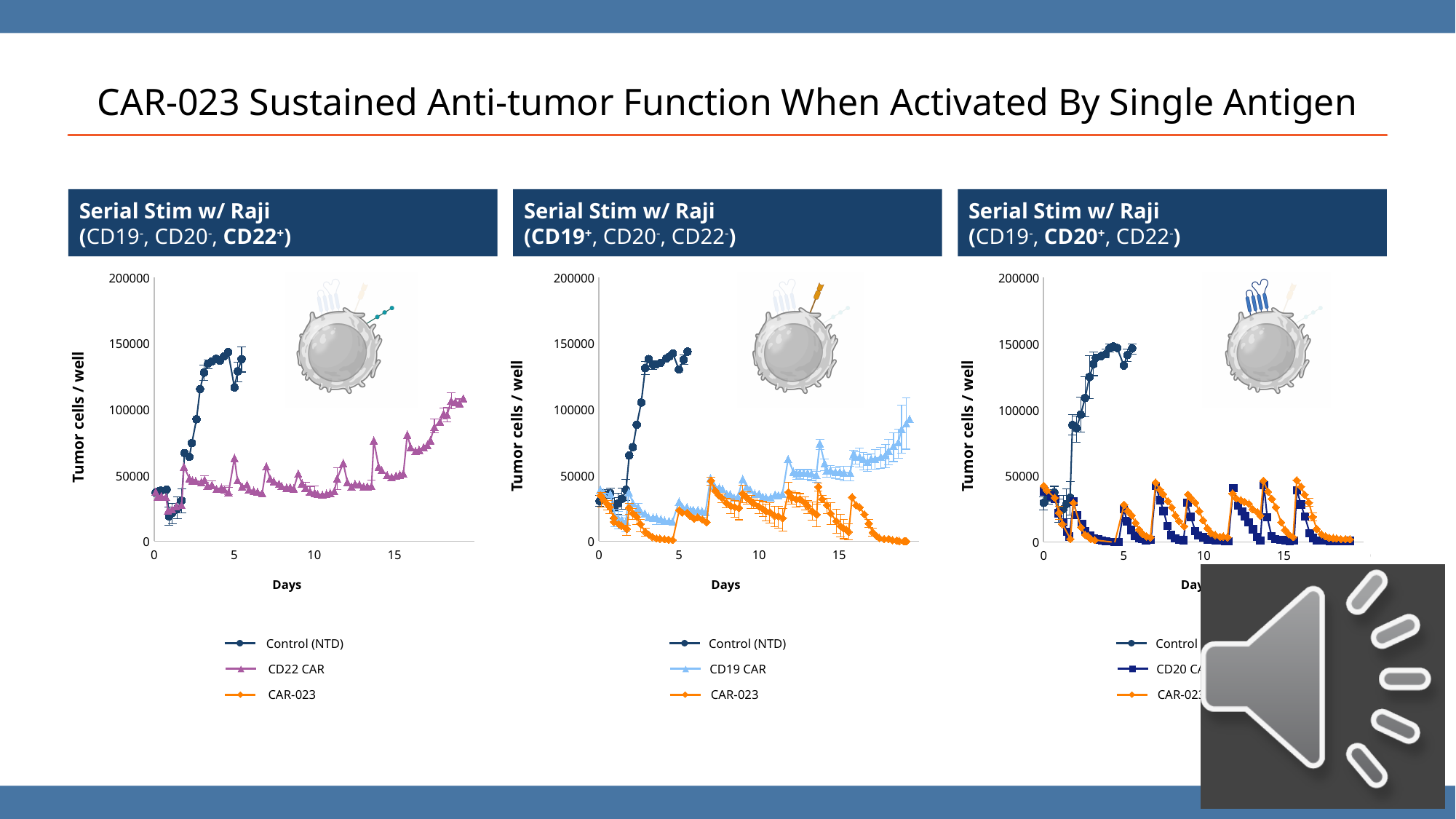
In the left chart (CD19-, CD20-, CD22+), does the CD22 CAR series rise or fall between day 15 and day 19? rise In the left chart (CD19-, CD20-, CD22+), is the value for Control (NTD) at day 5 greater or less than 100000? greater In the left chart (CD19-, CD20-, CD22+), how many series does the legend list? 3 What is the y-axis label of the middle chart (CD19+, CD20-, CD22-)? Tumor cells / well What kind of chart is the left chart titled 'Serial Stim w/ Raji (CD19-, CD20-, CD22+)'? line chart In the left chart (CD19-, CD20-, CD22+), which series is higher at day 5, Control (NTD) or CD22 CAR? Control (NTD) In the middle chart (CD19+, CD20-, CD22-), is the value for CAR-023 at day 19 greater or less than 50000? less How many charts are shown on the slide? 3 What is the x-axis label of the left chart (CD19-, CD20-, CD22+)? Days In the middle chart (CD19+, CD20-, CD22-), is the value for CD19 CAR at day 19 greater or less than 50000? greater In the middle chart (CD19+, CD20-, CD22-), which series is higher at day 15, CD19 CAR or CAR-023? CD19 CAR